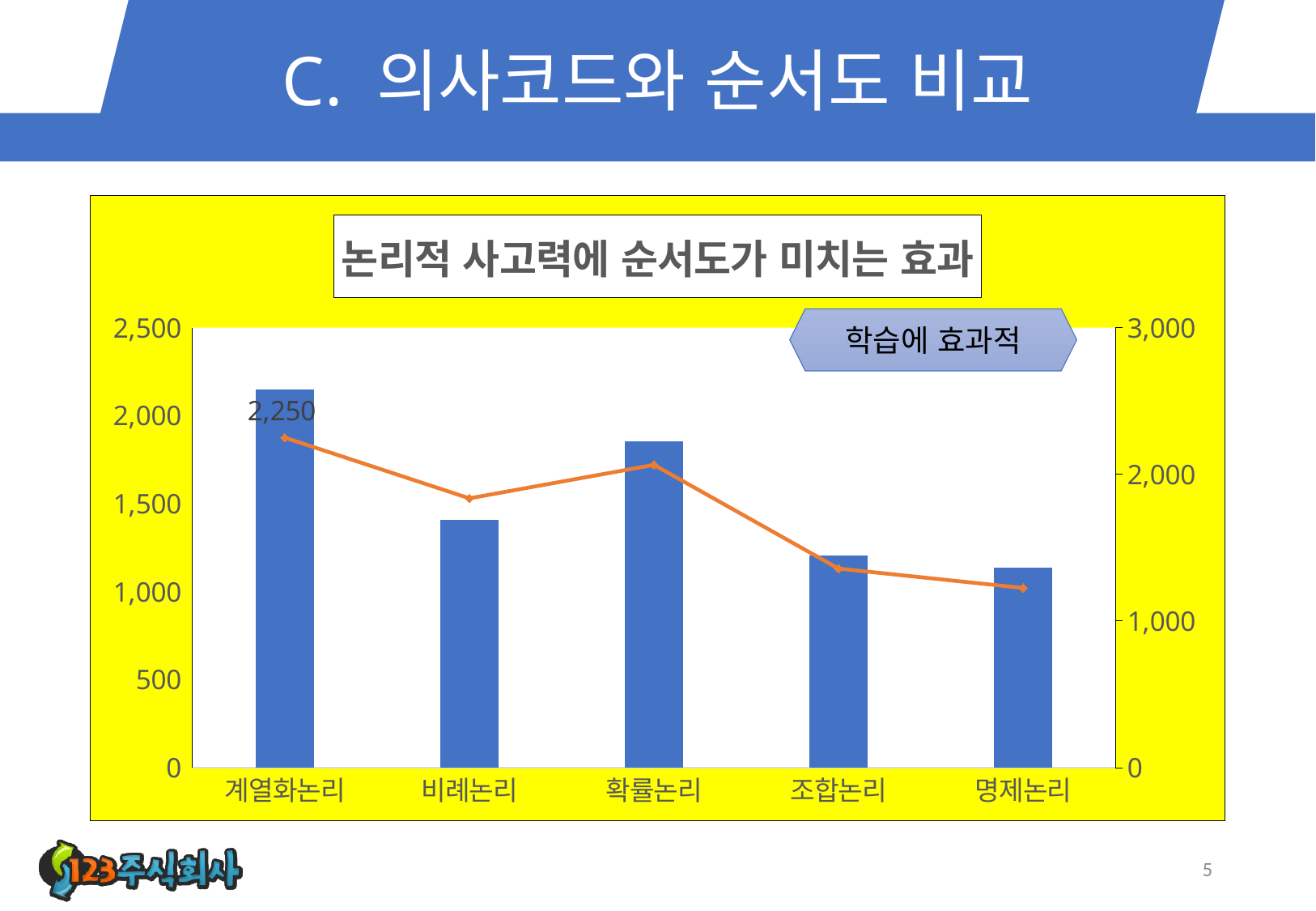
What value is printed as a data label on the chart, at 계열화논리? 2,250 Does the orange line generally rise or fall from left to right across the categories? fall Is the bar for 확률논리 greater or less than 1,500 on the left axis? greater What kind of chart is shown on the slide? A combination bar and line chart What is the maximum value shown on the right-hand axis? 3,000 Is the bar for 조합논리 greater or less than 1,500 on the left axis? less Which bar is taller, 비례논리 or 확률논리? 확률논리 How many categories are shown on the x axis? 5 Is the bar for 계열화논리 greater or less than 2,000 on the left axis? greater What is the title of the chart? 논리적 사고력에 순서도가 미치는 효과 Which category has the tallest bar? 계열화논리